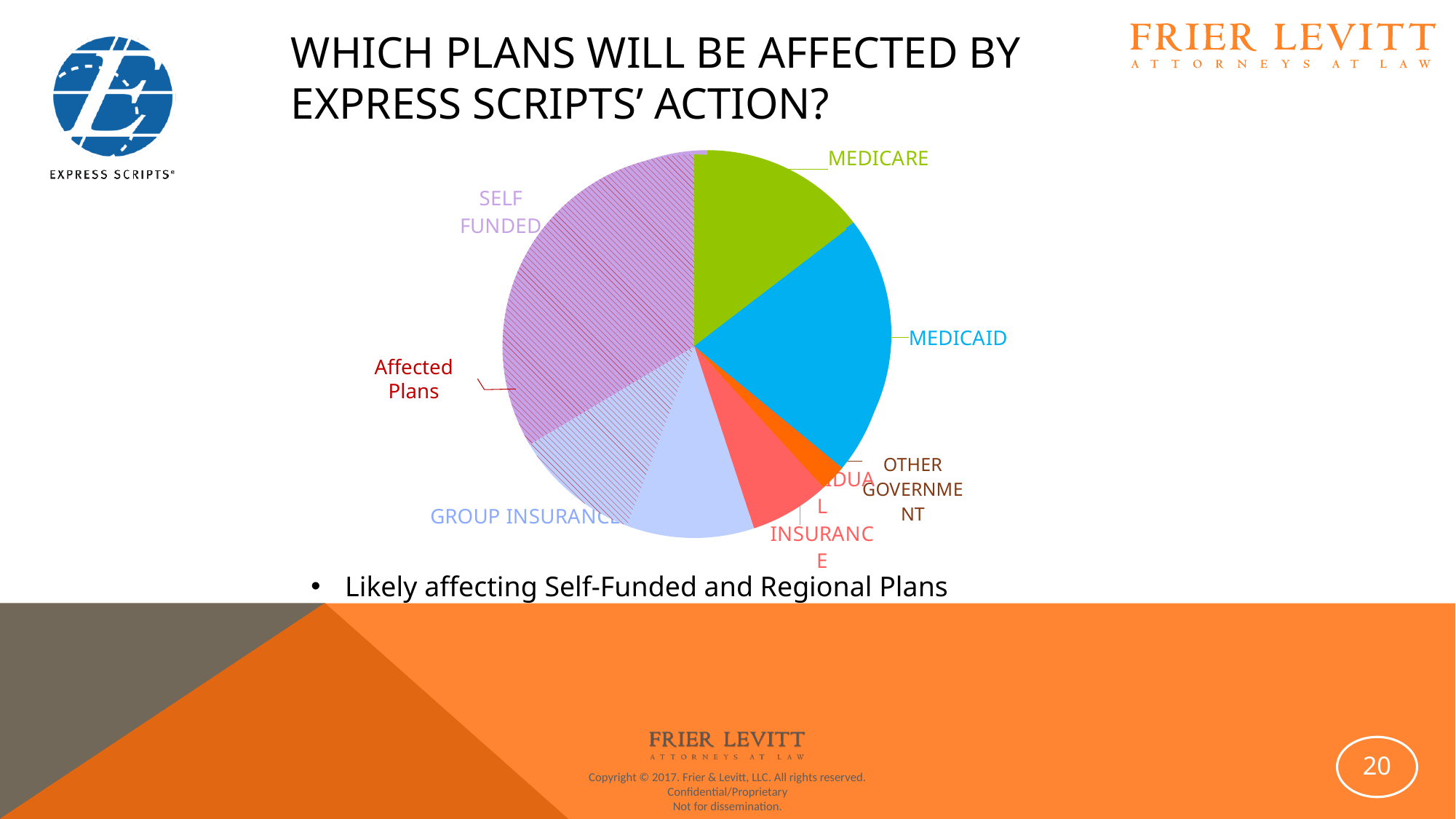
Which slice is larger, Medicare or Other Government? Medicare Which slice is larger, Self Funded or Group Insurance? Self Funded Which slice is larger, Medicaid or Medicare? Medicaid Which slice of the pie chart is marked with the annotation "Affected Plans"? Self Funded What kind of chart is shown on the slide? Pie chart Which slice of the pie chart is the smallest? Other Government What is the title of the slide containing the pie chart? Which plans will be affected by Express Scripts' action? Which slice of the pie chart is the largest? Self Funded